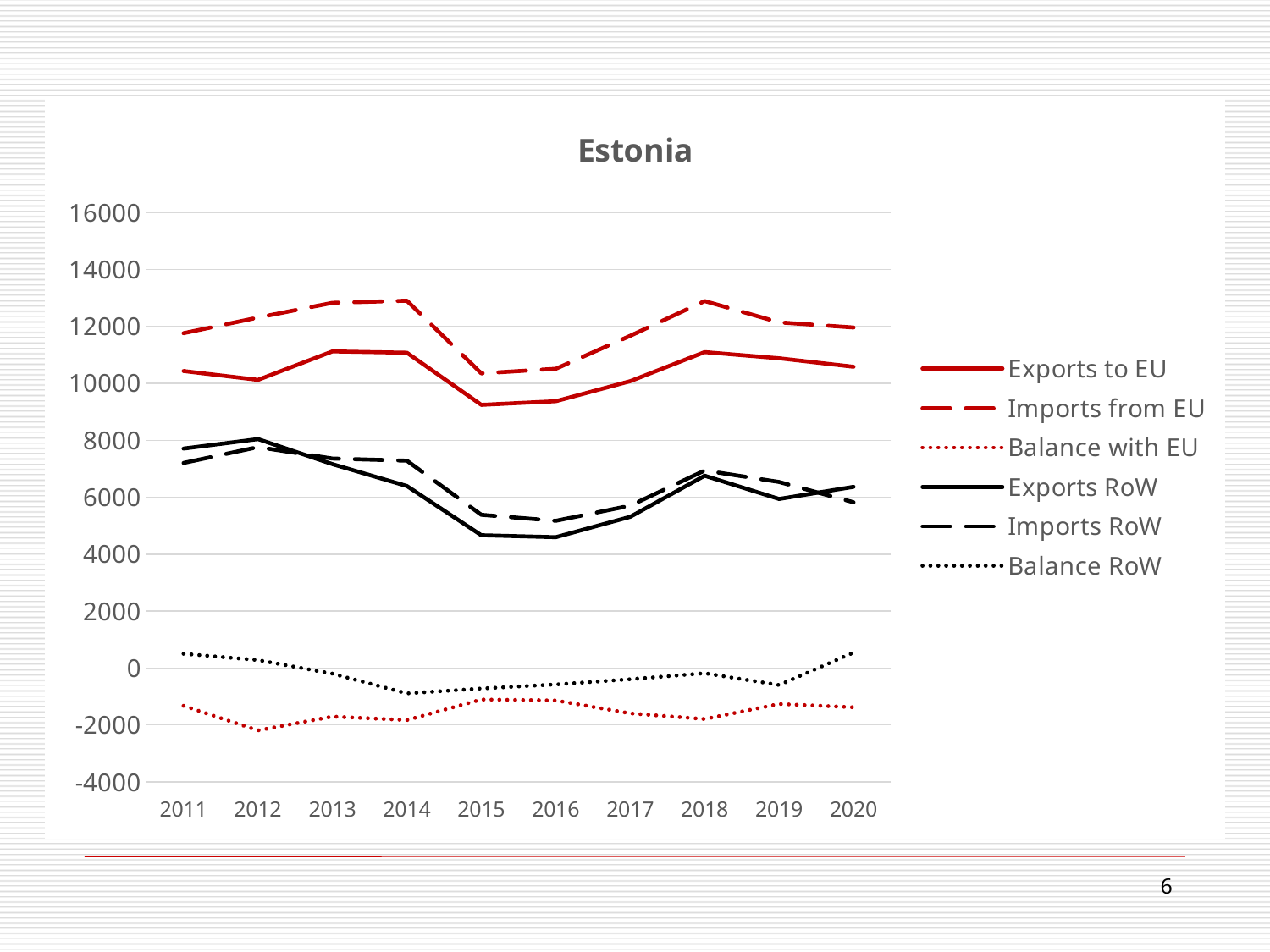
Is the value for Exports to EU in 2015 greater or less than 10000? less How many series does the legend list? 6 Is the value for Imports from EU in 2014 greater or less than 12000? greater In 2015, which is larger: Imports from EU or Exports to EU? Imports from EU How many years are shown on the x axis? 10 Is the value for Balance RoW in 2011 greater or less than 0? greater In which year is Balance with EU at its lowest? 2012 What is the title of the chart? Estonia In which year is Exports to EU at its lowest? 2015 What kind of chart is shown on the slide? line chart Does Exports to EU rise or fall from 2015 to 2018? rise